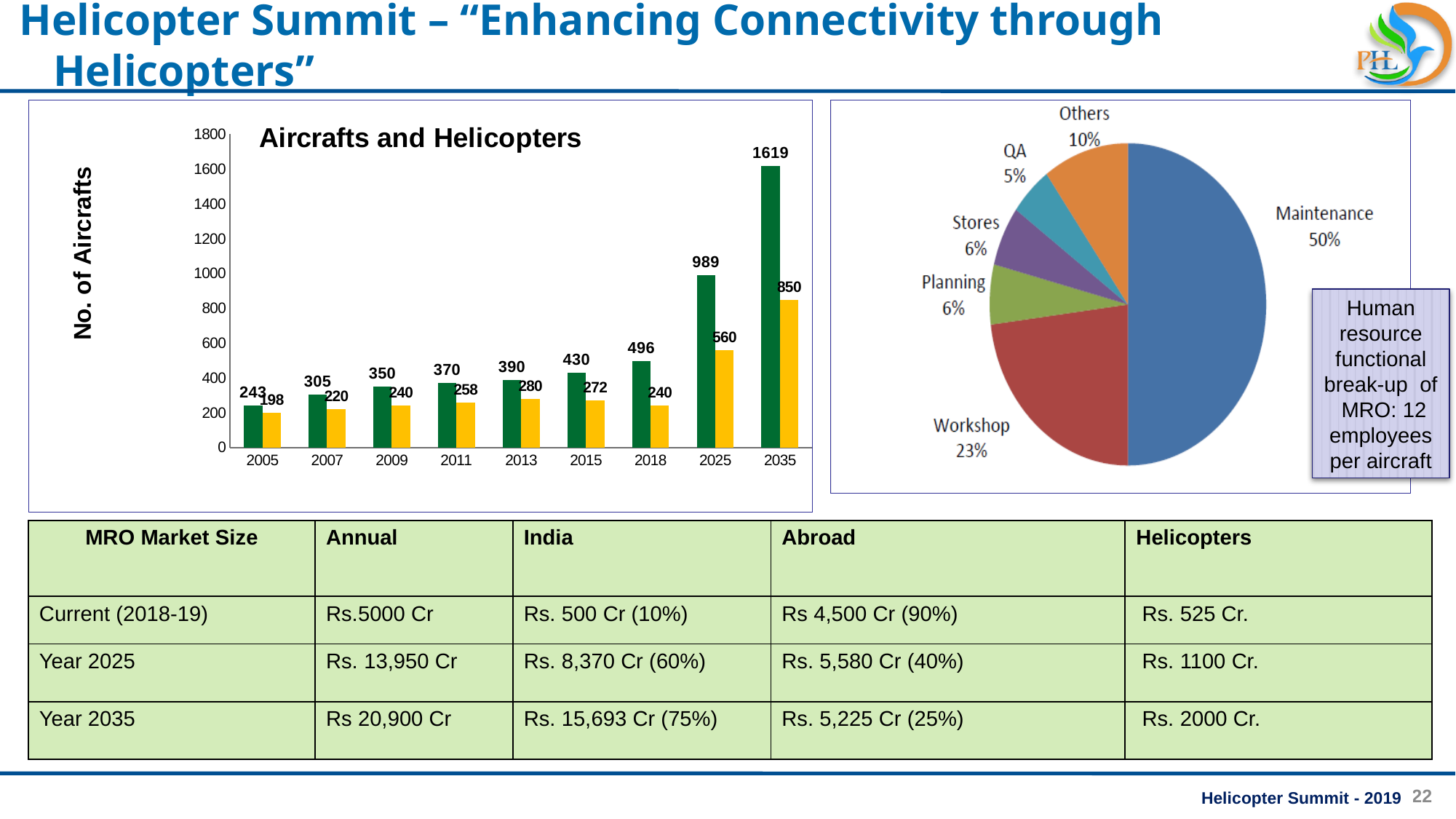
In the 'Aircrafts and Helicopters' bar chart, what is the value of the green bar for 2035? 1619 In the 'Aircrafts and Helicopters' bar chart, do the green bars rise or fall from 2005 to 2035? rise In the 'Aircrafts and Helicopters' bar chart, what is the difference between the green and yellow bars for 2035? 769 In the 'Aircrafts and Helicopters' bar chart, what is the value of the yellow bar for 2025? 560 In the 'Aircrafts and Helicopters' bar chart, which is larger: the yellow bar for 2015 or the yellow bar for 2018? 2015 How many years are shown on the x axis of the 'Aircrafts and Helicopters' bar chart? 9 In the 'Aircrafts and Helicopters' bar chart, what is the value of the green bar for 2018? 496 In the pie chart on the right, which function has the largest slice? Maintenance In the 'Aircrafts and Helicopters' bar chart, which year has the lowest green bar? 2005 What type of chart is 'Aircrafts and Helicopters'? bar chart In the pie chart on the right, what share does Workshop have? 23% In the pie chart on the right, which function has the smallest slice? QA